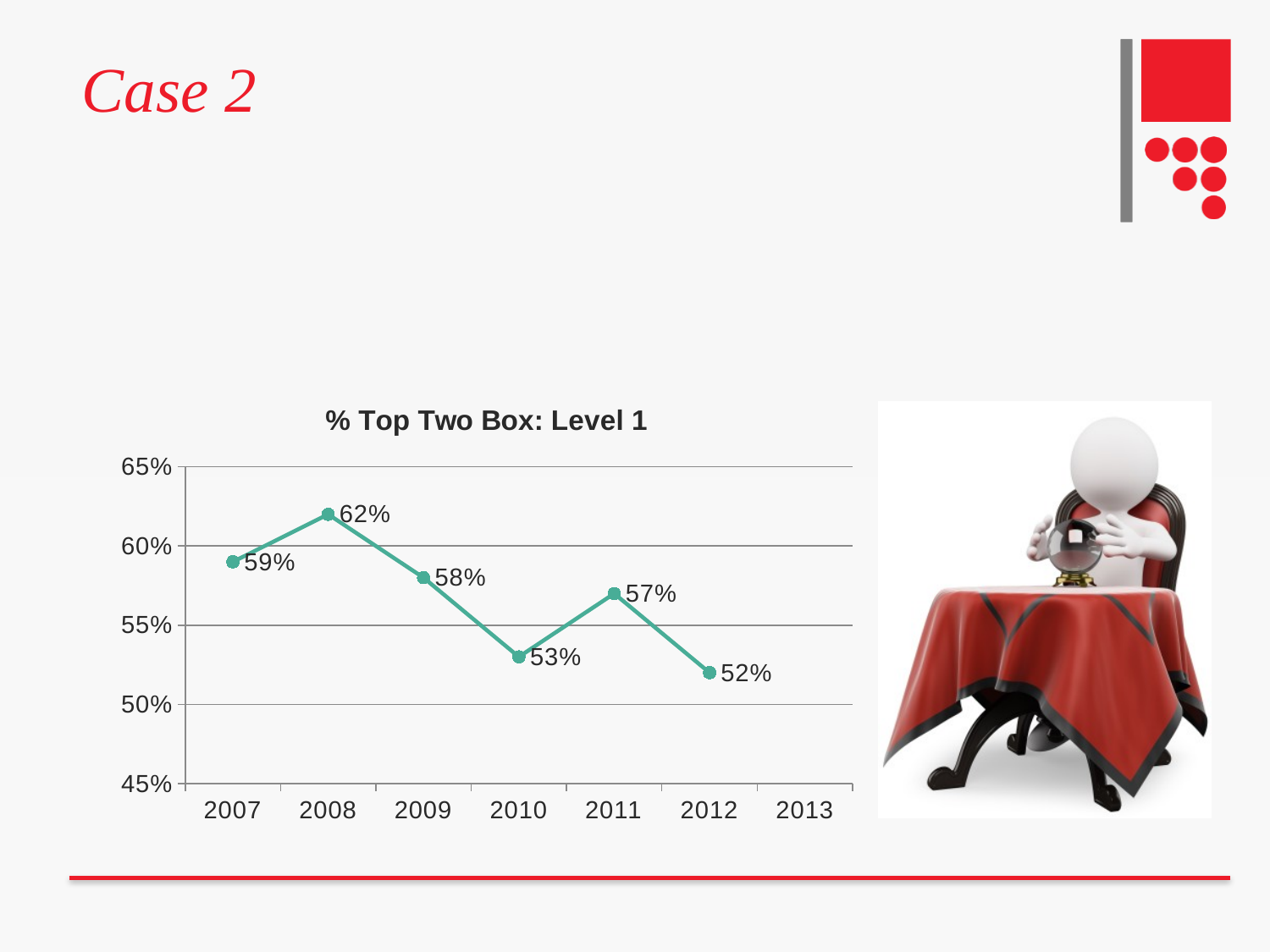
What is the difference between the values for 2008 and 2012? 10% What kind of chart is shown? line chart What is the value for 2010? 53% What is the title of the chart? % Top Two Box: Level 1 Does the value rise or fall from 2008 to 2010? fall Which year has the highest value? 2008 How many data points are plotted on the line? 6 Which year has the lowest value? 2012 Is the value for 2007 greater or less than 55%? greater What is the value for 2008? 62% Which is larger, the value for 2009 or the value for 2011? 2009 What is the value for 2012? 52%